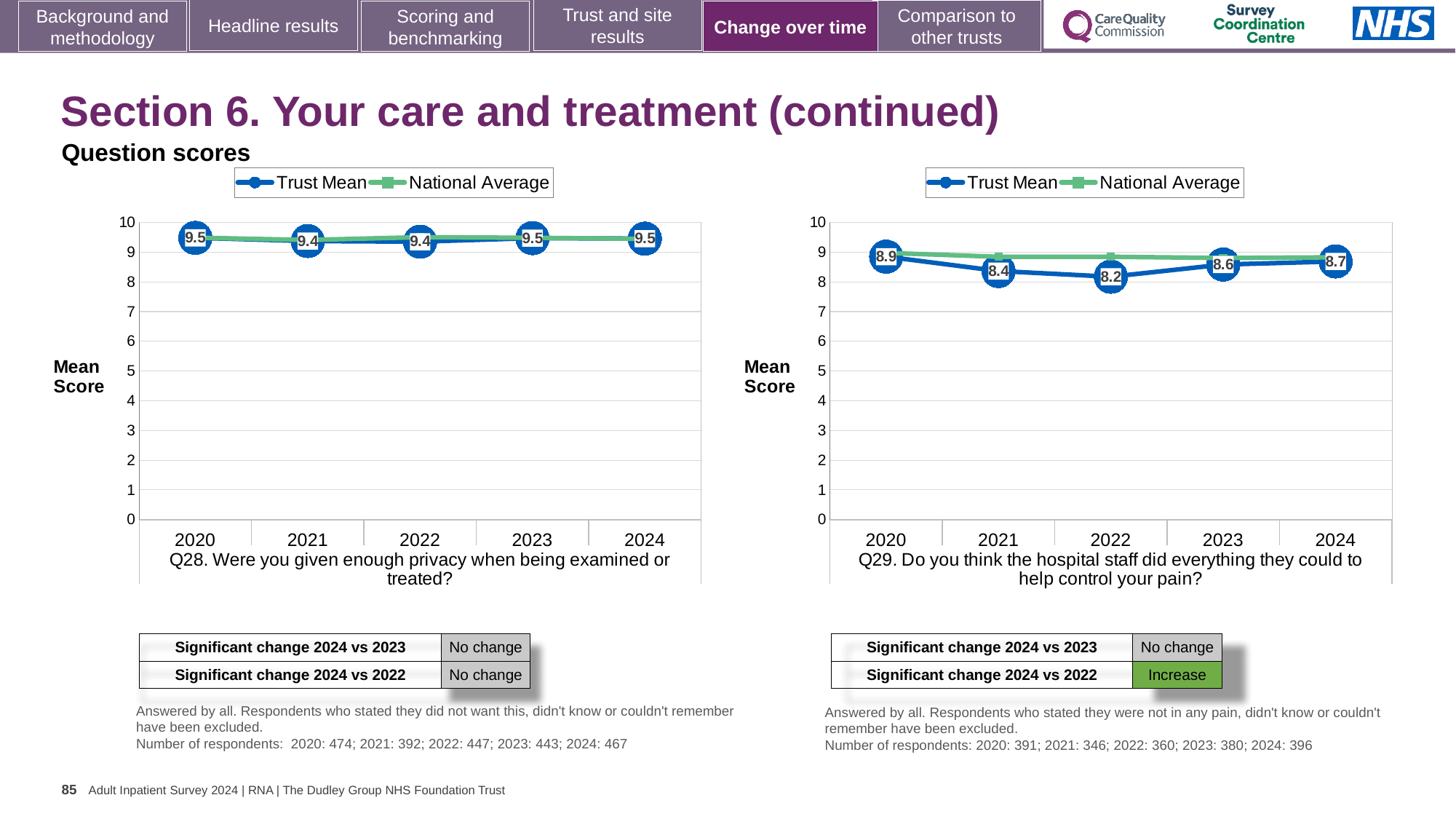
In the Q29 chart, which year has the lowest Trust Mean score? 2022 How many series does the legend of the Q29 chart list? 2 In the Q29 chart, which year has the highest Trust Mean score? 2020 How many years are plotted on the x axis of the Q28 chart? 5 In the Q29 chart, is the National Average for 2022 greater or less than 8? greater What kind of chart is used for Q28? Line chart In the Q28 chart, what is the Trust Mean score for 2024? 9.5 In the Q29 chart, does the Trust Mean rise or fall from 2022 to 2024? Rise In the Q29 chart, is the Trust Mean score higher in 2023 or in 2021? 2023 In the Q28 chart, what is the Trust Mean score for 2021? 9.4 In the Q29 chart, what is the Trust Mean score for 2022? 8.2 In the Q29 chart, what is the difference between the Trust Mean scores for 2020 and 2022? 0.7